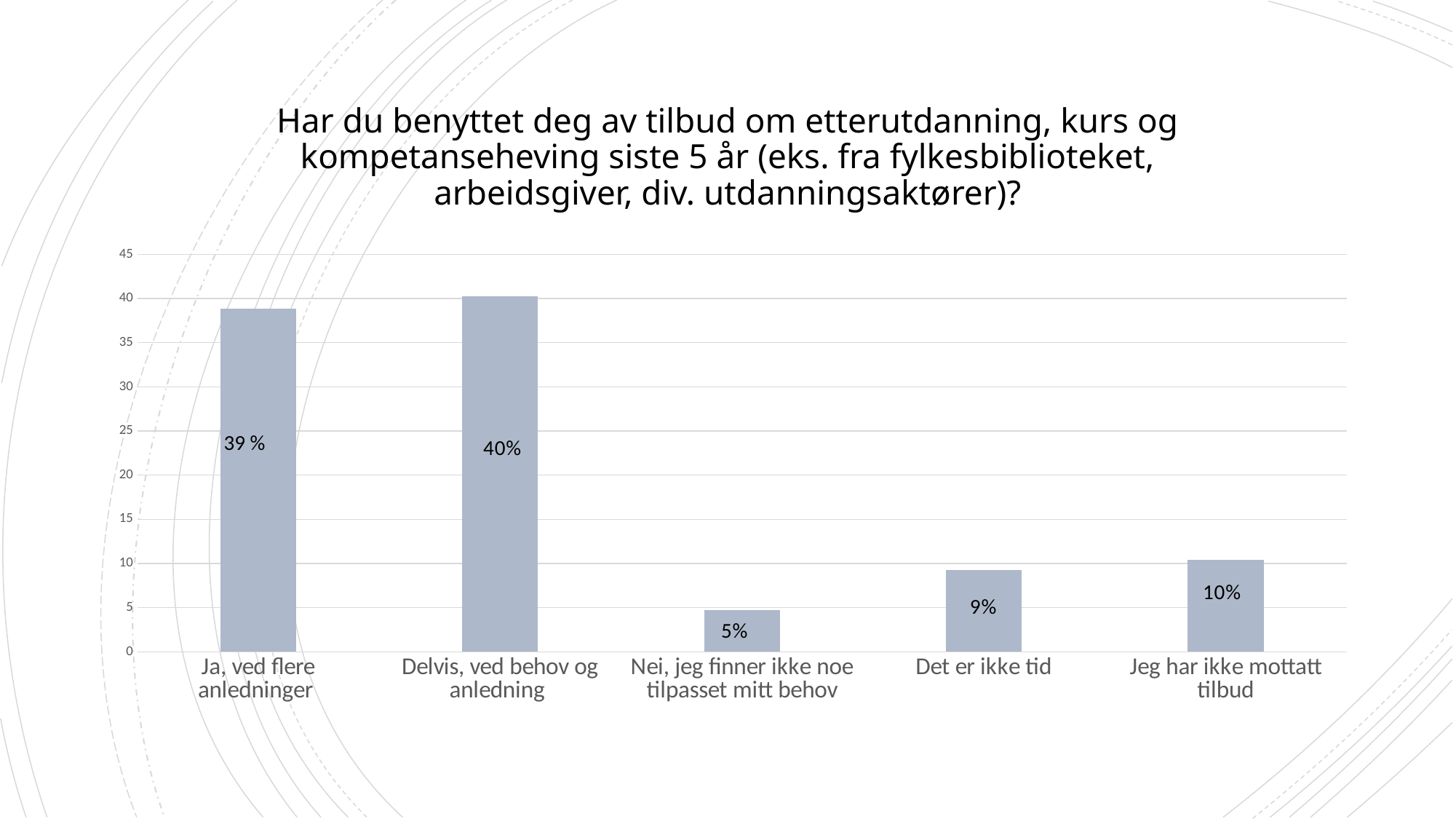
What is the value for "Det er ikke tid"? 9% What is the value for "Ja, ved flere anledninger"? 39 % Which category has the highest value? Delvis, ved behov og anledning Which is larger, the value for "Jeg har ikke mottatt tilbud" or the value for "Nei, jeg finner ikke noe tilpasset mitt behov"? Jeg har ikke mottatt tilbud How many categories are shown on the x axis? 5 Which category has the lowest value? Nei, jeg finner ikke noe tilpasset mitt behov What is the difference between the values for "Delvis, ved behov og anledning" and "Nei, jeg finner ikke noe tilpasset mitt behov"? 35% What is the value for "Nei, jeg finner ikke noe tilpasset mitt behov"? 5% What is the value for "Delvis, ved behov og anledning"? 40% What is the value for "Jeg har ikke mottatt tilbud"? 10% Is the value for "Ja, ved flere anledninger" greater or less than 35? greater What kind of chart is shown on the slide? bar chart